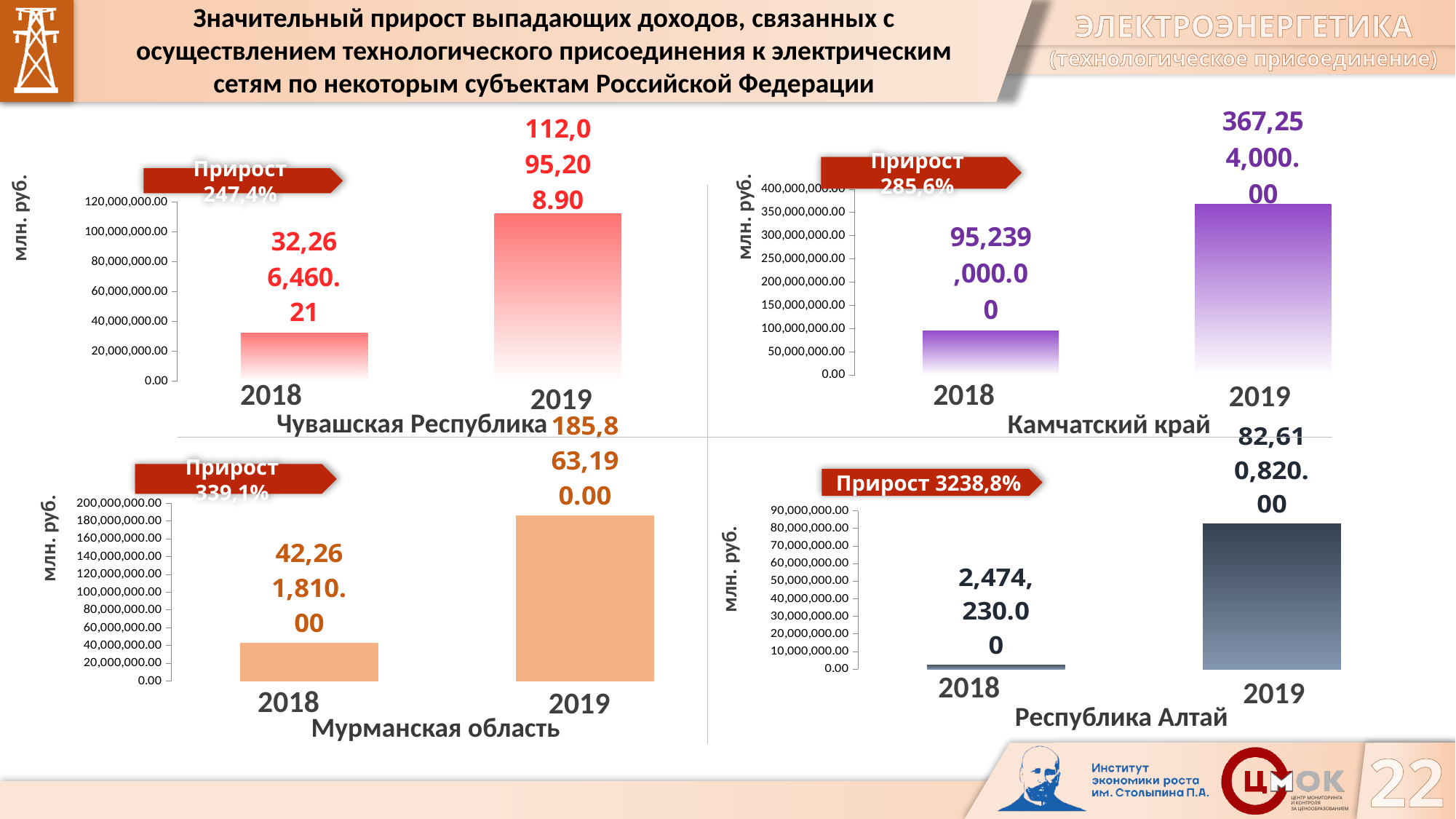
In the Камчатский край chart, what is the value for 2018? 95,239,000.00 How many categories are shown on the x axis of the Республика Алтай chart? 2 In the Мурманская область chart, is the value for 2018 greater or less than 60,000,000.00? less In the Камчатский край chart, what is the difference between the 2019 and 2018 values? 272,015,000.00 In the Мурманская область chart, what is the value for 2019? 185,863,190.00 In the Республика Алтай chart, what is the value for 2018? 2,474,230.00 In the Чувашская Республика chart, what is the value for 2019? 112,095,208.90 In the Чувашская Республика chart, which year has the higher value? 2019 In the Мурманская область chart, what is the difference between the 2019 and 2018 values? 143,601,380.00 What kind of chart is used for Камчатский край? bar chart In the Республика Алтай chart, which year has the lowest value? 2018 What growth percentage (Прирост) is shown for the Республика Алтай chart? 3238,8%